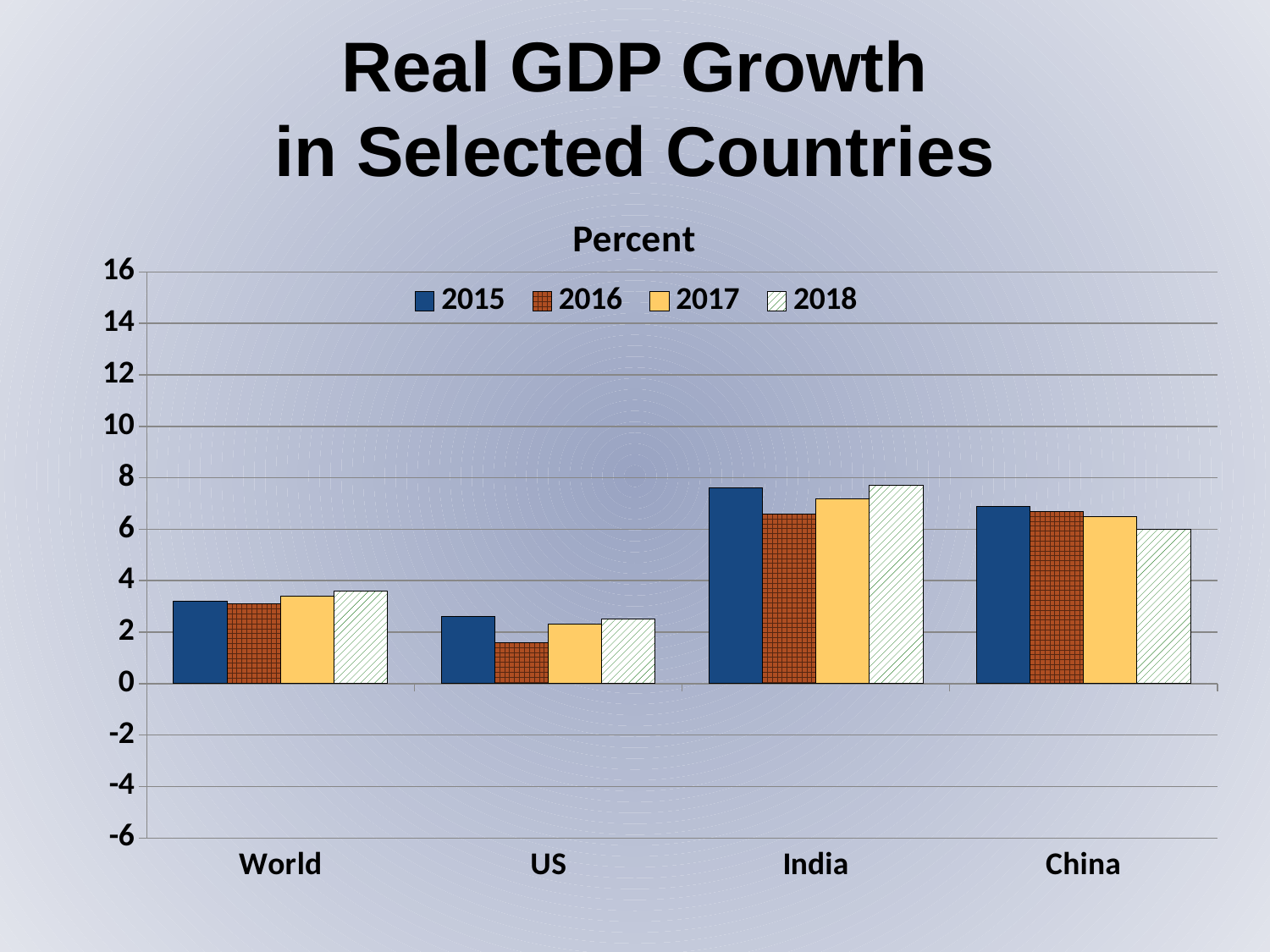
Is the 2017 value for World greater or less than 4? less Do China's values rise or fall from 2015 to 2018? fall How many series does the legend list? 4 Is the 2016 value for the US greater or less than 2? less How many countries/regions are shown on the x axis? 4 Which country/region has the lowest 2016 value? US Which years are listed in the legend? 2015, 2016, 2017, 2018 What kind of chart is shown on the slide? bar chart Is the 2015 value for India greater or less than 6? greater Which has the larger 2015 value, India or the US? India Which country/region has the highest 2018 value? India